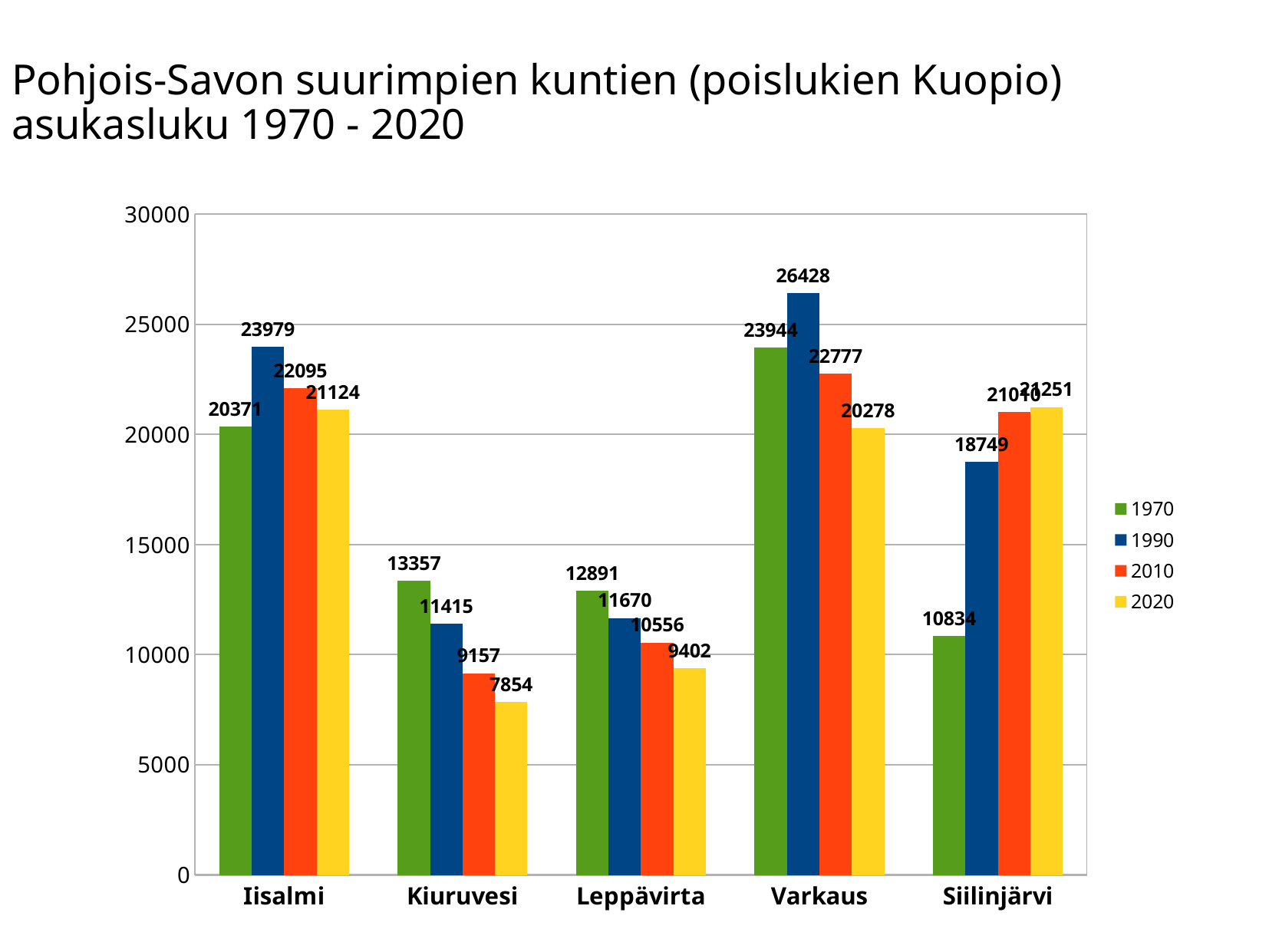
What is the difference between the 1990 and 2020 values for Varkaus? 6150 What kind of chart is shown on the slide? bar chart How many series does the legend list? 4 Which municipality has the highest value for 1990? Varkaus What is the value for Kiuruvesi in 2020? 7854 What is the difference between the 1990 and 1970 values for Iisalmi? 3608 Which municipality has the lowest value for 2020? Kiuruvesi What is the value for Varkaus in 1990? 26428 Which is larger, the 2010 value for Leppävirta or the 2010 value for Kiuruvesi? Leppävirta How many municipalities are shown on the x axis? 5 Do the values for Kiuruvesi rise or fall from 1970 to 2020? fall What is the value for Siilinjärvi in 1970? 10834